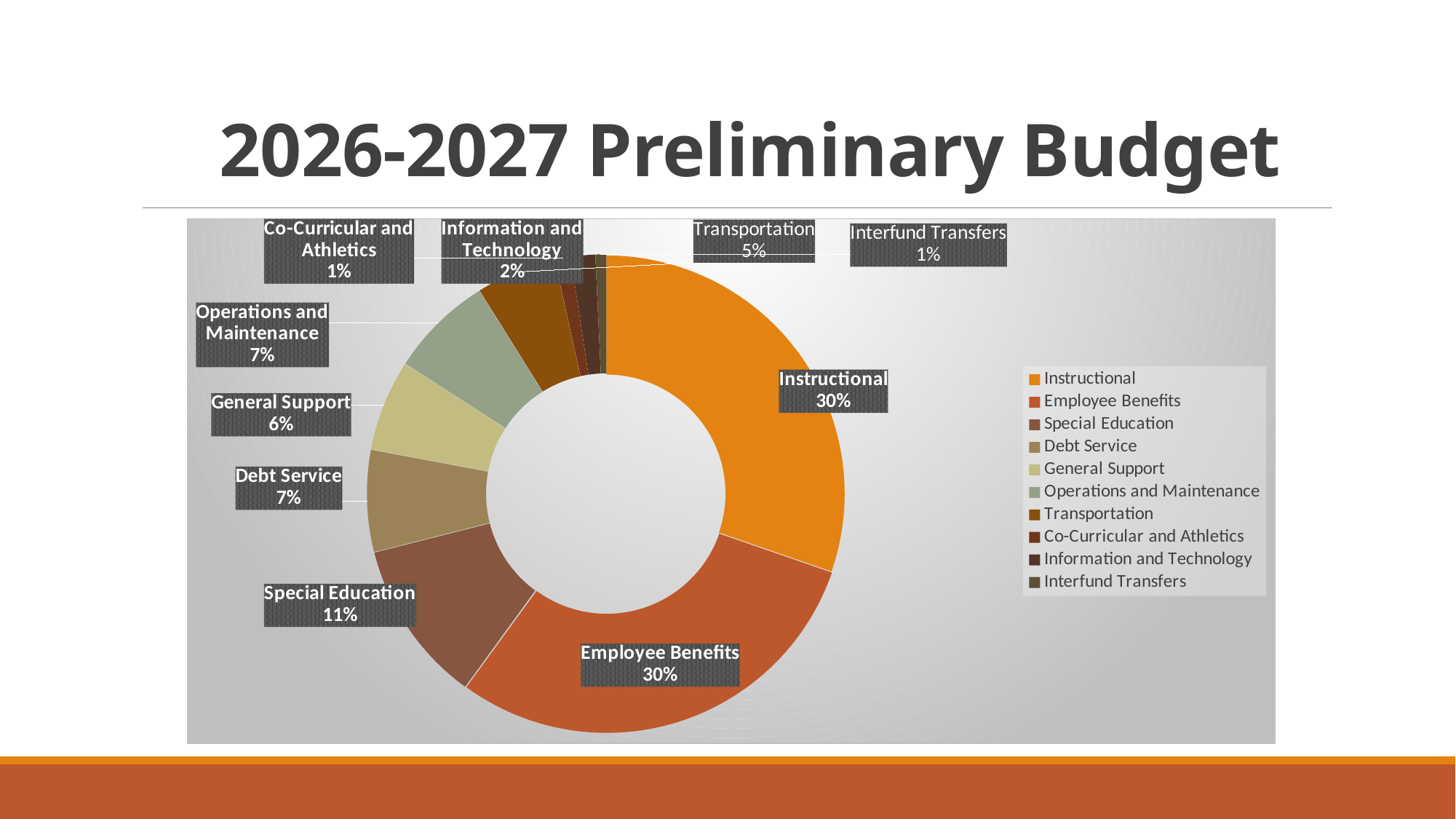
Which is larger, Special Education or General Support? Special Education What is the title of the slide containing the chart? 2026-2027 Preliminary Budget What is the value for Information and Technology? 2% What percentage is labelled for Transportation? 5% What is the value shown for Debt Service? 7% What is the difference between the Special Education share and the Transportation share? 6% What percentage of the budget is Instructional? 30% How many categories does the chart show? 10 Which legend entry is listed first? Instructional What kind of chart is shown on the slide? Doughnut (pie) chart What percentage is shown for Operations and Maintenance? 7% What share of the budget goes to Special Education? 11%